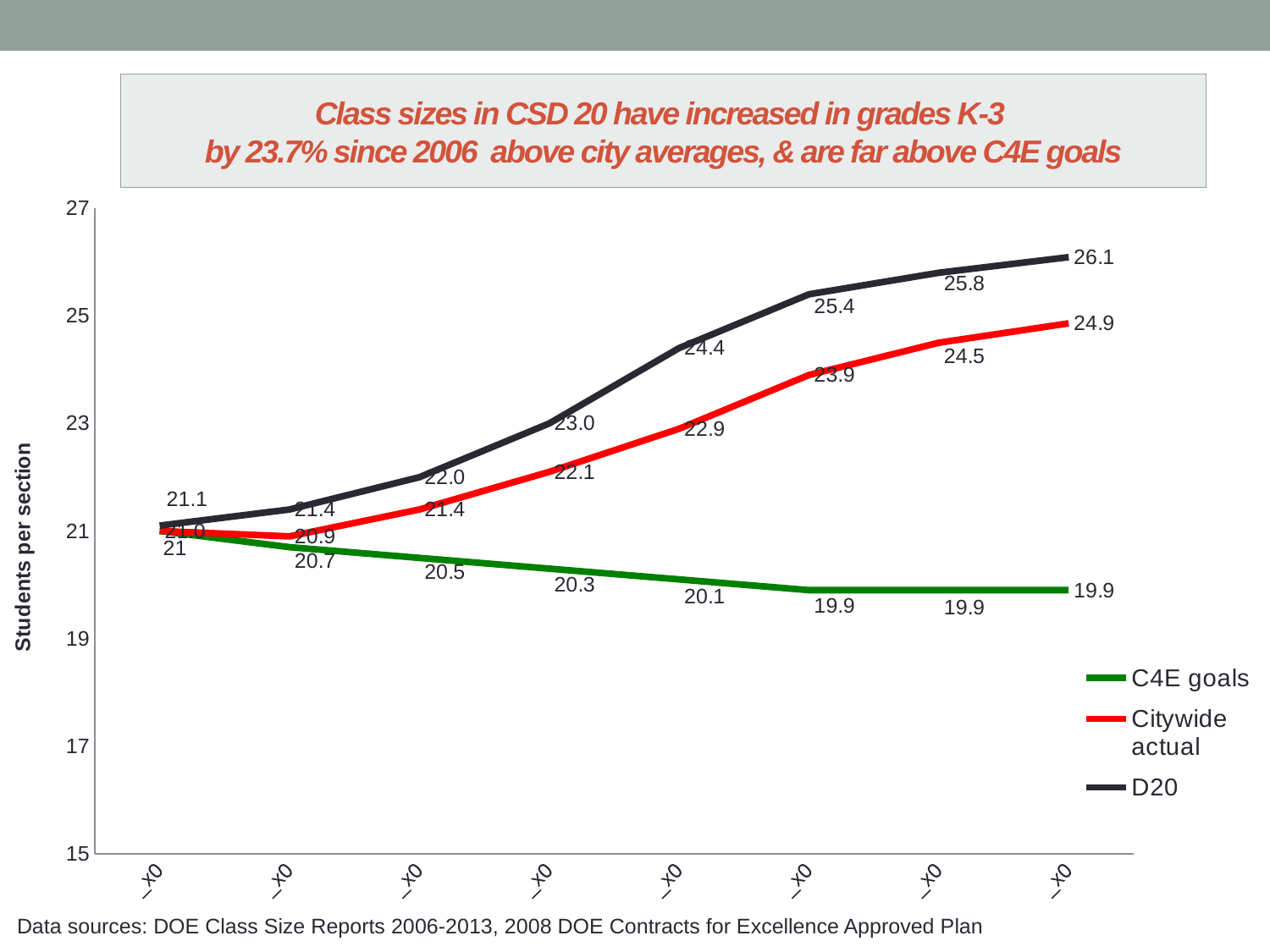
What is the lowest value on the C4E goals line? 19.9 What is the value of the first point on the D20 line? 21.1 What is the value of the last point on the D20 line? 26.1 What is the highest value on the D20 line? 26.1 Do the values on the D20 line rise or fall from left to right? rise How many series does the legend list? 3 What is the value of the last point on the Citywide actual line? 24.9 What kind of chart is shown on the slide? line chart What is the difference between the last D20 value and the last Citywide actual value? 1.2 How many data points does the D20 line have? 8 At the last point, which is larger: the D20 value or the C4E goals value? D20 What is the title of the vertical axis? Students per section